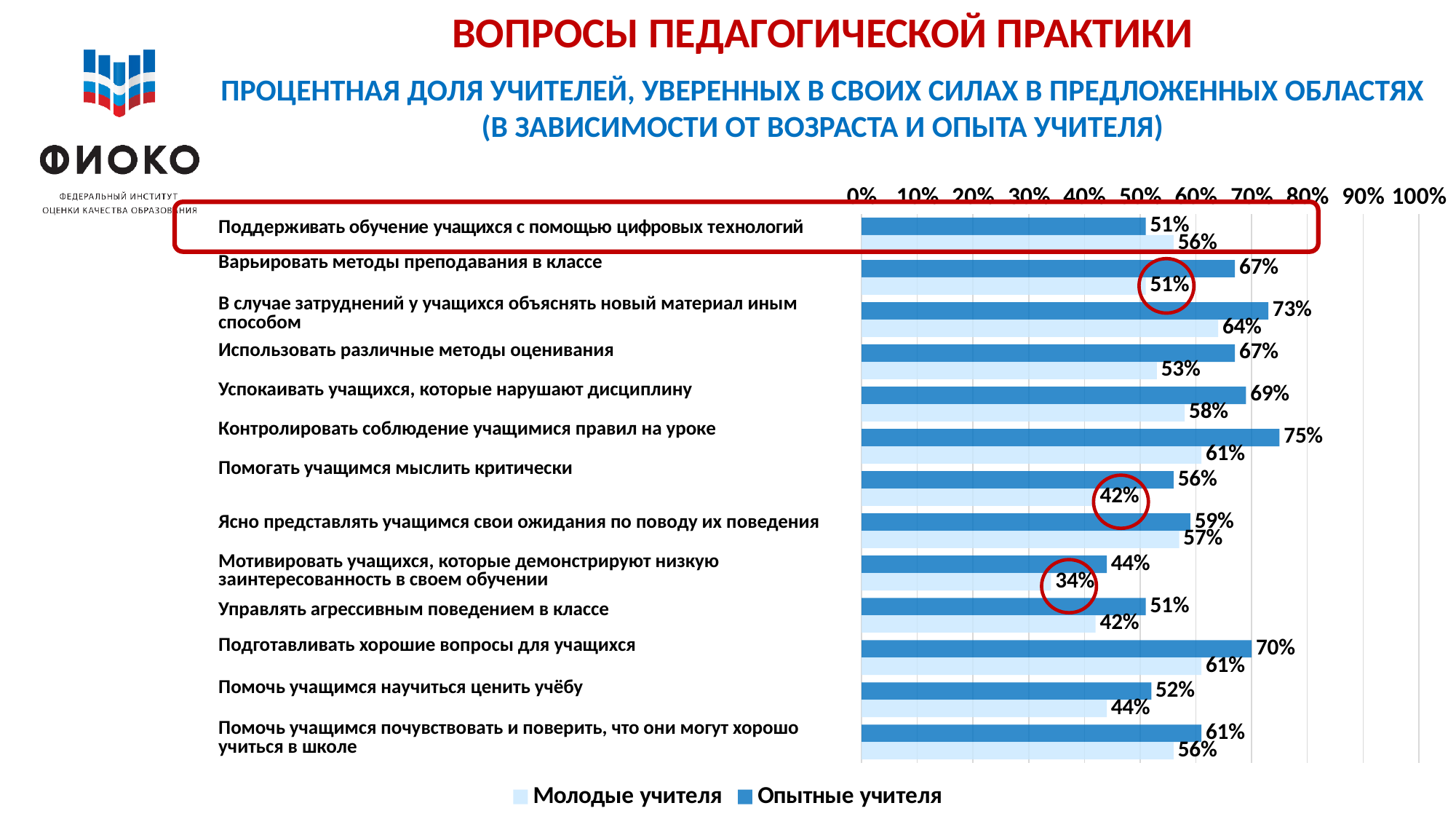
What is the value for Молодые учителя in the category «Мотивировать учащихся, которые демонстрируют низкую заинтересованность в своем обучении»? 34% In the category «Поддерживать обучение учащихся с помощью цифровых технологий», which series has the larger value: Молодые учителя or Опытные учителя? Молодые учителя What is the difference between Опытные учителя and Молодые учителя in the category «Варьировать методы преподавания в классе»? 16 percentage points What is the value for Опытные учителя in the category «Контролировать соблюдение учащимися правил на уроке»? 75% How many categories (areas of teaching practice) are shown in the chart? 13 What type of chart is shown on the slide? Bar chart In which category is the value for Молодые учителя the lowest? Мотивировать учащихся, которые демонстрируют низкую заинтересованность в своем обучении What is the value for Молодые учителя in the category «Поддерживать обучение учащихся с помощью цифровых технологий»? 56% In which category is the value for Опытные учителя the highest? Контролировать соблюдение учащимися правил на уроке Which series is shown in dark blue in the legend? Опытные учителя How many series does the legend list? 2 What is the difference between Опытные учителя and Молодые учителя in the category «Помогать учащимся мыслить критически»? 14 percentage points